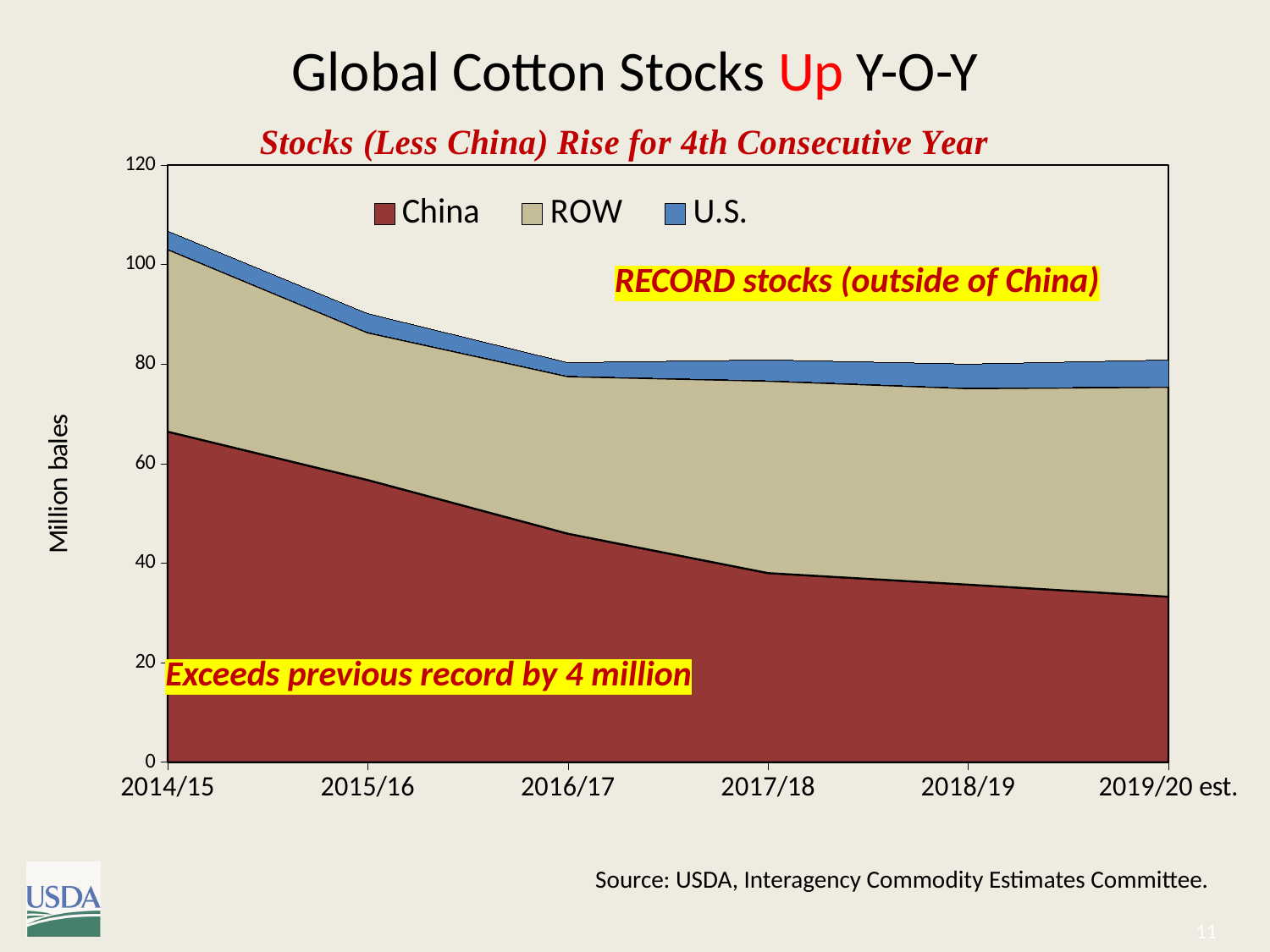
Is the value for China in 2019/20 est. greater or less than 40? less Which series are listed in the legend? China, ROW, U.S. Which is larger, China's stocks in 2014/15 or in 2017/18? 2014/15 Is the total global cotton stock in 2019/20 est. greater or less than 100? less What is the label on the y axis? Million bales How many series does the legend list? 3 Is the total global cotton stock in 2014/15 greater or less than 100? greater How many marketing years are shown on the x axis? 6 What kind of chart is shown on the slide? stacked area chart Do China's cotton stocks rise or fall from 2014/15 to 2019/20 est.? fall In which year is the total global cotton stock highest? 2014/15